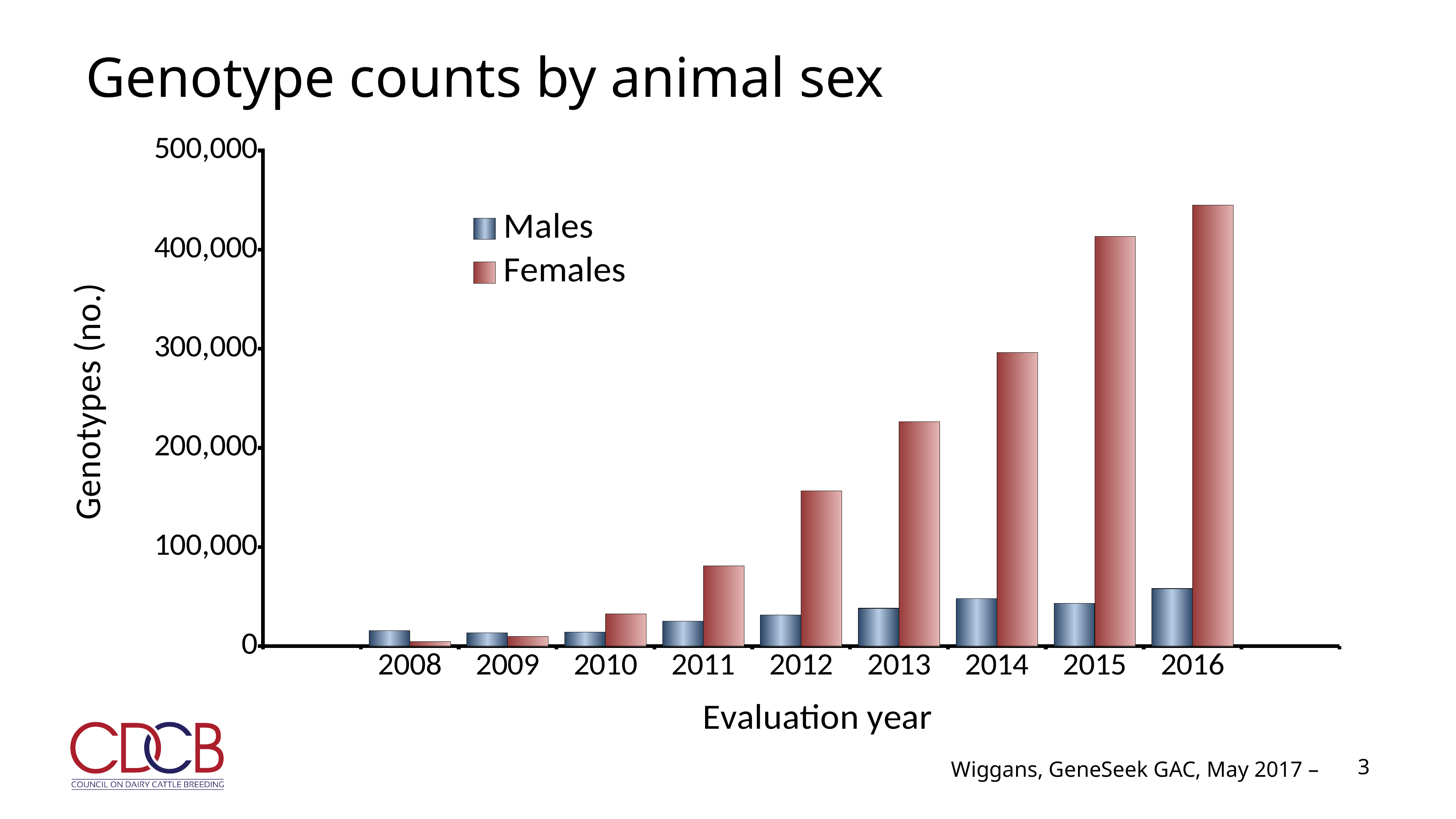
Which is larger in 2008, the Males value or the Females value? Males Which is larger in 2013, the Males value or the Females value? Females Is the Males value for 2016 greater or less than 100,000? less What kind of chart is shown on the slide? bar chart How many series does the legend list? 2 Is the Females value for 2016 greater or less than 400,000? greater Which year has the lowest Females value? 2008 How many evaluation years are shown on the x axis? 9 What is the title of the chart? Genotype counts by animal sex Do the Females values rise or fall from 2009 to 2016? rise Which year has the highest Females value? 2016